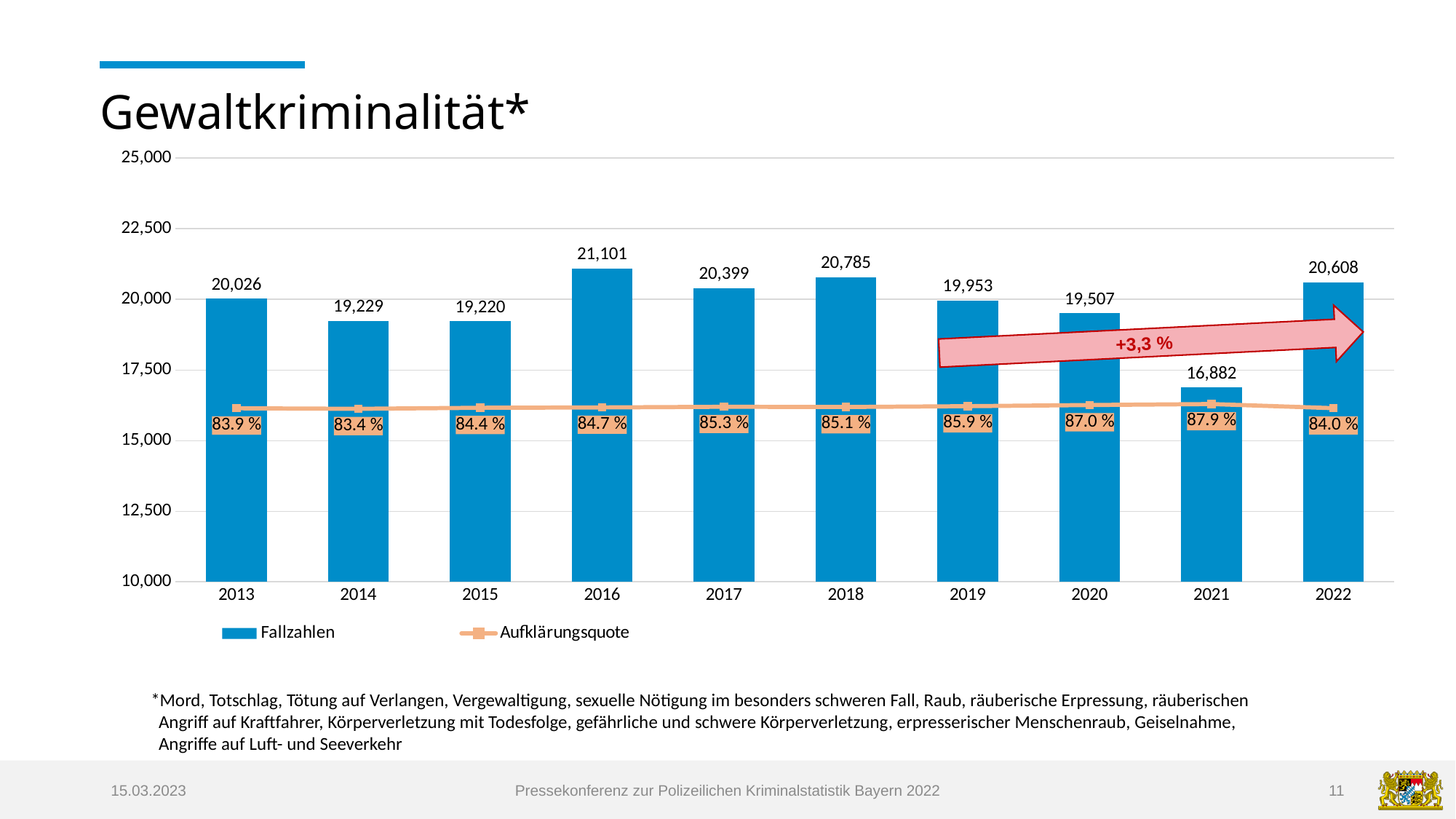
Which year has the larger Fallzahlen value, 2018 or 2017? 2018 Which year has the lowest Aufklärungsquote? 2014 What is the Fallzahlen value for 2021? 16,882 What percentage change is printed on the red arrow? +3,3 % How many years are shown on the x axis? 10 Which year has the highest Aufklärungsquote? 2021 What is the Aufklärungsquote for 2020? 87.0 % Which year has the lowest Fallzahlen value? 2021 Which year has the highest Fallzahlen value? 2016 How many series does the legend list? 2 What is the Fallzahlen value for 2016? 21,101 What is the difference in Fallzahlen between 2022 and 2021? 3,726